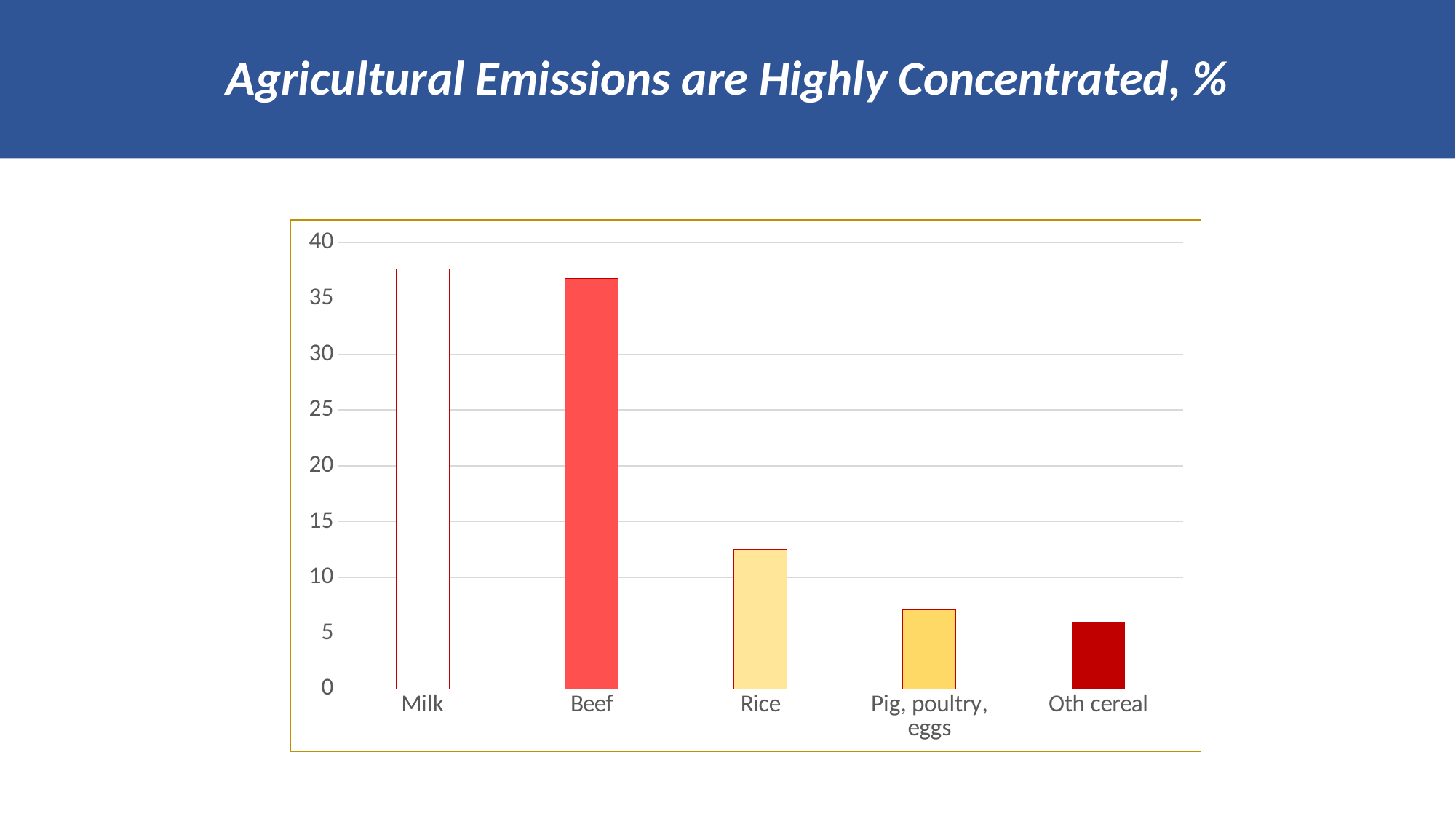
Is the value for Pig, poultry, eggs greater or less than 10? less Is the value for Milk greater or less than 35? greater What kind of chart is shown on the slide? bar chart What is the title of the chart on the slide? Agricultural Emissions are Highly Concentrated, % How many categories are shown on the x axis of the chart? 5 Is the value for Oth cereal greater or less than 5? greater Which is larger, the value for Rice or the value for Oth cereal? Rice Do the values generally rise or fall moving from left to right along the x axis? fall Which is larger, the value for Beef or the value for Rice? Beef